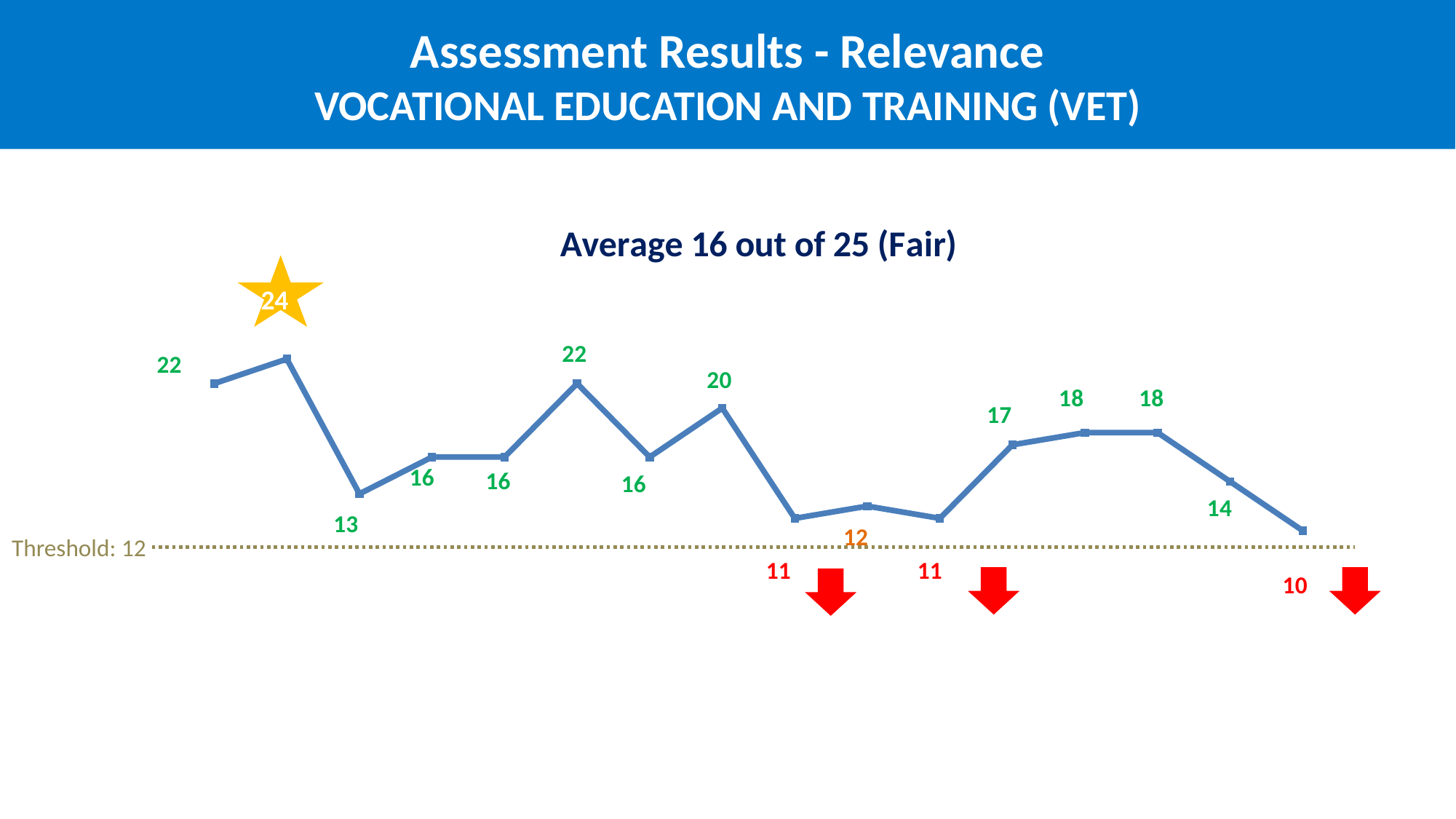
What kind of chart is shown on the slide? line chart What is the value of the last point on the line? 10 What threshold value is marked by the dotted line? 12 What is the lowest value plotted on the chart? 10 What is the difference between the first point (22) and the last point (10)? 12 What is the difference between the highest and lowest values on the chart? 14 Which is larger, the second point or the third point on the line? the second point (24) How many data points are plotted on the line? 16 What is the highest value plotted on the chart? 24 What is the value of the first point on the line? 22 What average score is stated in the chart title? 16 out of 25 (Fair) Overall, do the values rise or fall from the first point to the last point? fall